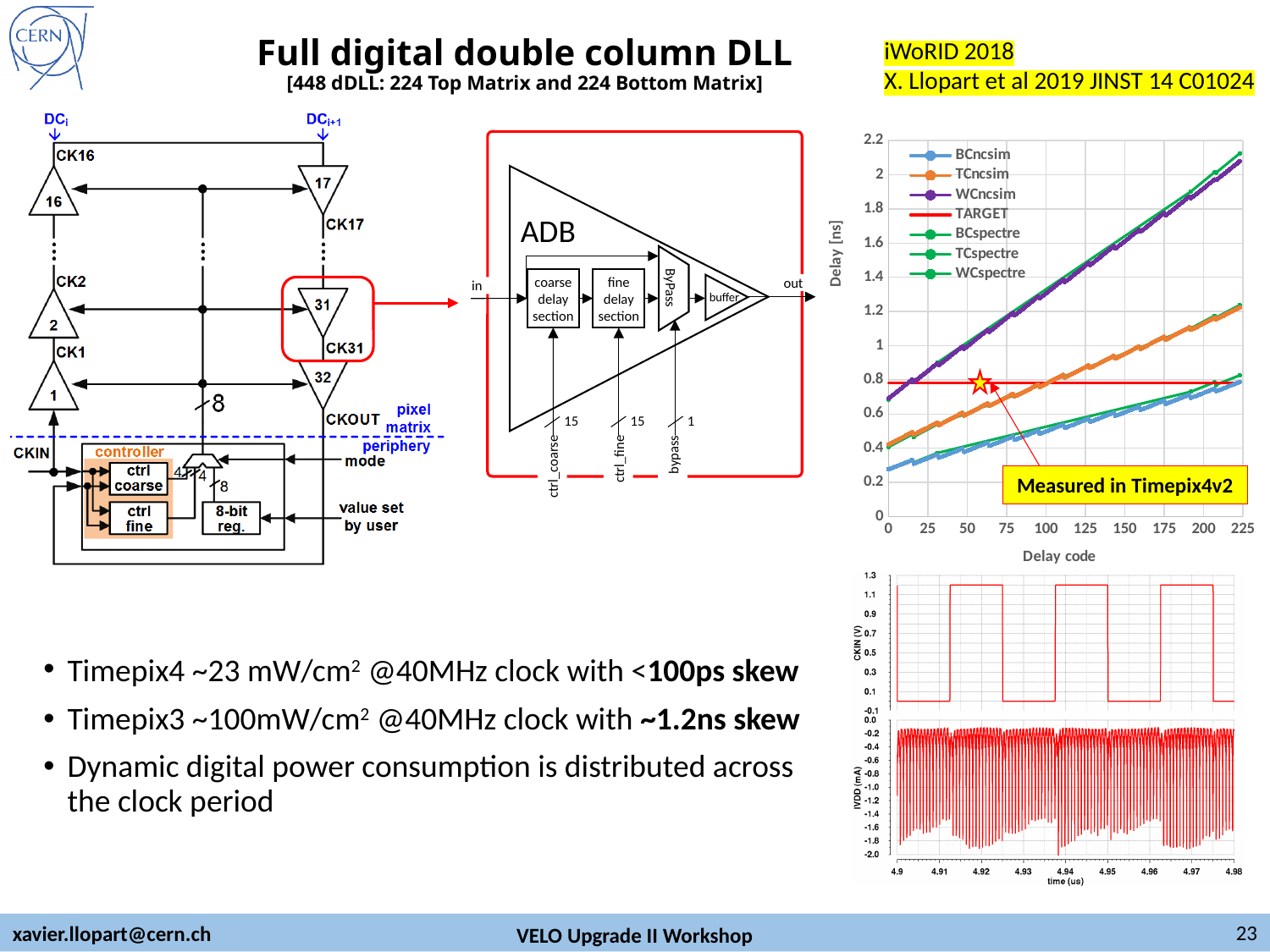
In the Delay vs Delay code chart, at delay code 225, which is larger: WCncsim or TCncsim? WCncsim In the Delay vs Delay code chart, is the TCncsim value at delay code 225 greater or less than 1? greater In the Delay vs Delay code chart, is the WCncsim value at delay code 225 greater or less than 1.8? greater In the Delay vs Delay code chart, how many series does the legend list? 7 In the Delay vs Delay code chart, do the delay values rise or fall as the delay code increases? rise In the Delay vs Delay code chart, what is the label of the x axis? Delay code In the Delay vs Delay code chart, is the BCncsim value at delay code 0 greater or less than 0.4? less What kind of chart is the Delay vs Delay code chart in the upper right? line chart In the lower-right chart, what is the label of the x axis? time (us) In the Delay vs Delay code chart, what is the label of the y axis? Delay [ns] In the Delay vs Delay code chart, at delay code 225, which is larger: TCncsim or BCncsim? TCncsim